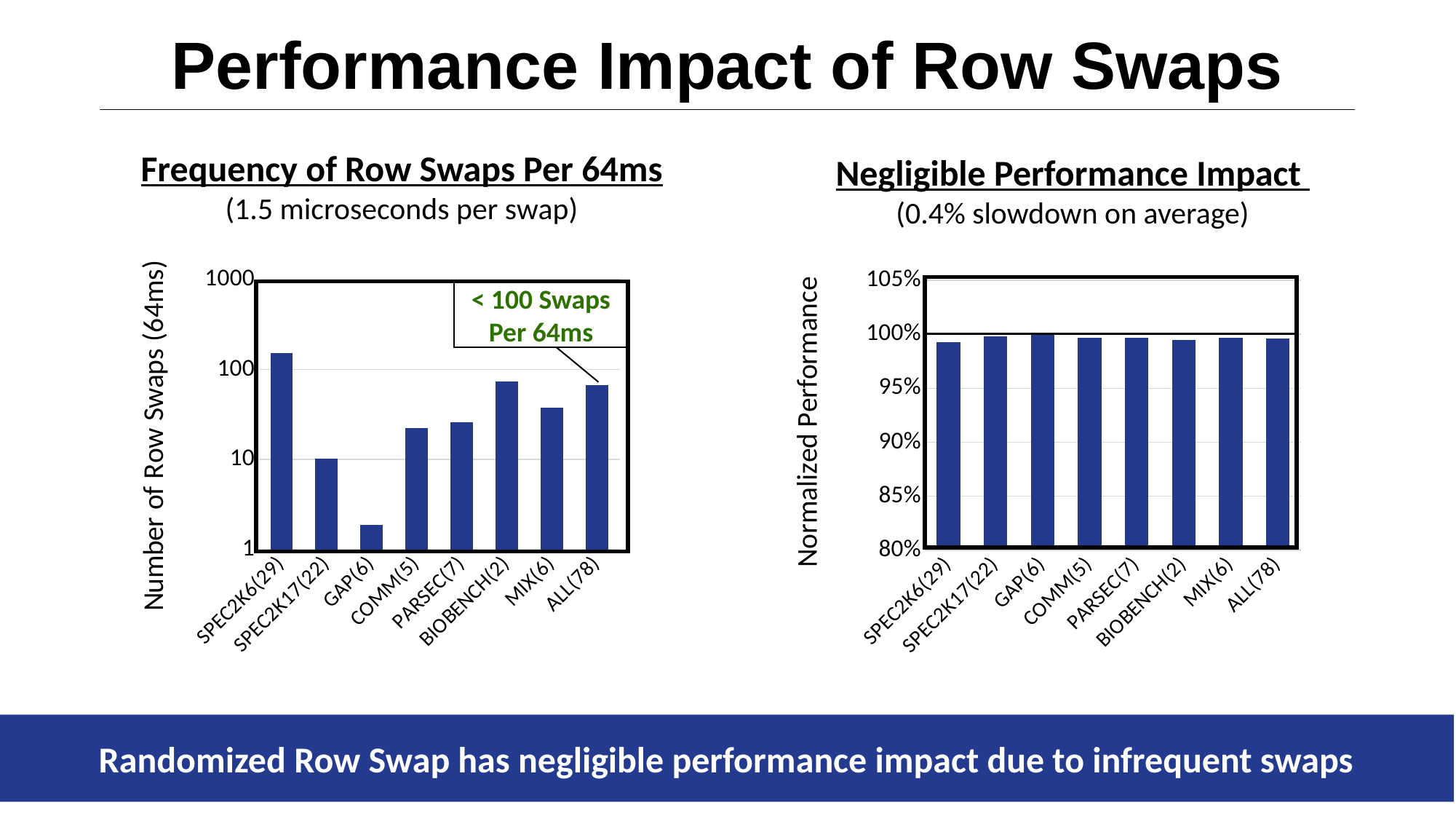
In the 'Negligible Performance Impact' chart, is the normalized performance for SPEC2K6(29) greater or less than 95%? greater In the 'Frequency of Row Swaps Per 64ms' chart, is the value for SPEC2K6(29) greater or less than 100? greater How many categories are shown on the x axis of the 'Frequency of Row Swaps Per 64ms' chart? 8 In the 'Frequency of Row Swaps Per 64ms' chart, which has more row swaps, SPEC2K17(22) or COMM(5)? COMM(5) In the 'Frequency of Row Swaps Per 64ms' chart, is the value for GAP(6) greater or less than 10? less How many categories are shown on the x axis of the 'Negligible Performance Impact' chart on the right? 8 In the 'Frequency of Row Swaps Per 64ms' chart, which category has the lowest number of row swaps? GAP(6) In the 'Frequency of Row Swaps Per 64ms' chart, which category has the highest number of row swaps? SPEC2K6(29) In the 'Frequency of Row Swaps Per 64ms' chart, which has more row swaps, BIOBENCH(2) or MIX(6)? BIOBENCH(2) What does the callout annotation in the 'Frequency of Row Swaps Per 64ms' chart say? < 100 Swaps Per 64ms What kind of chart is the 'Frequency of Row Swaps Per 64ms' chart on the left? bar chart What is the y-axis label of the 'Negligible Performance Impact' chart on the right? Normalized Performance